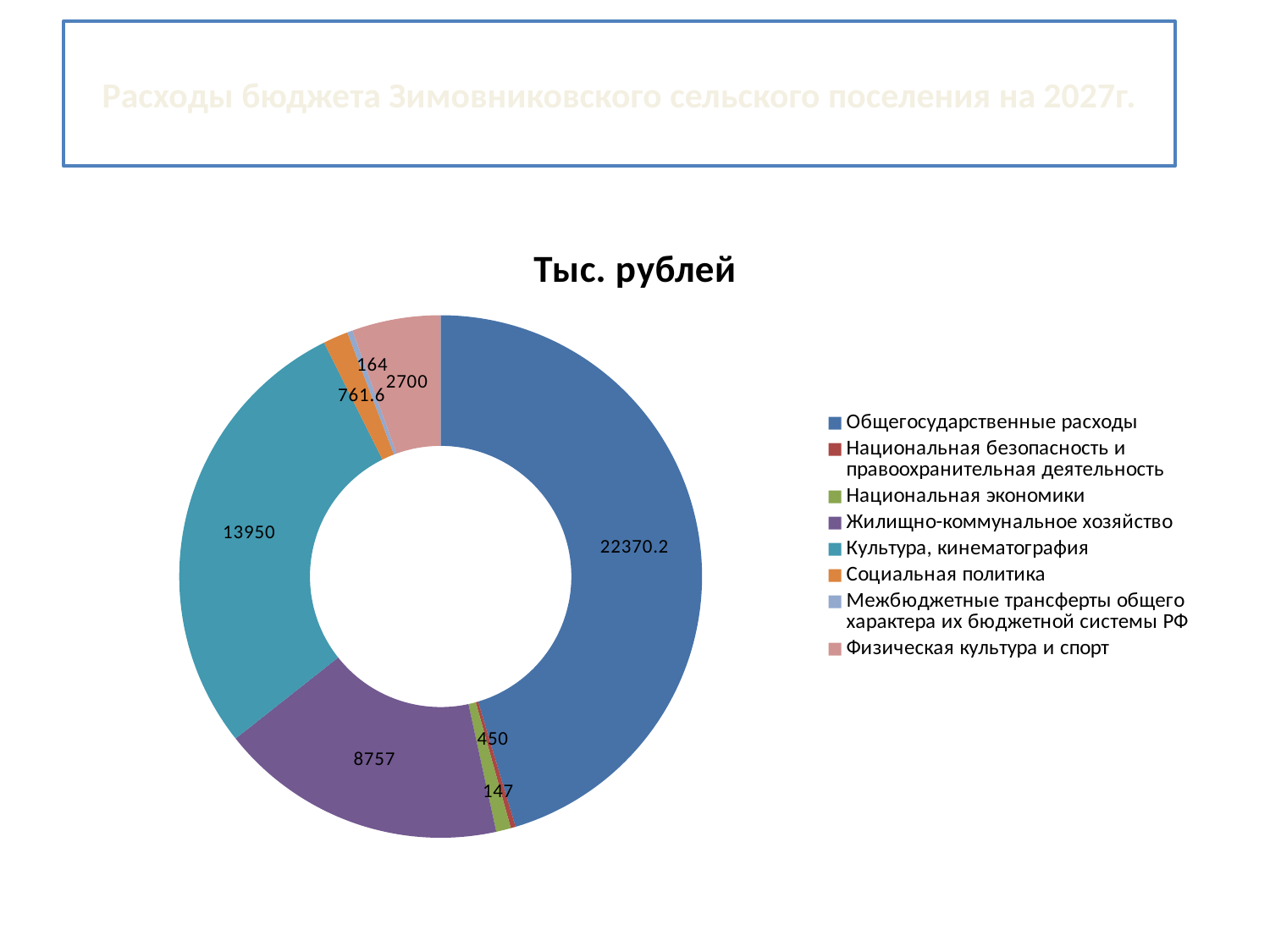
What is the title of the chart? Тыс. рублей Which category has the highest value? Общегосударственные расходы What is the value for Общегосударственные расходы? 22370.2 What kind of chart is shown on the slide? doughnut chart What is the value for Культура, кинематография? 13950 How many categories does the chart show? 8 Which category has the lowest value? Национальная безопасность и правоохранительная деятельность What is the value for Социальная политика? 761.6 What is the difference between Общегосударственные расходы and Культура, кинематография? 8420.2 What is the difference between Национальная экономики and Национальная безопасность и правоохранительная деятельность? 303 Which is larger, Жилищно-коммунальное хозяйство or Физическая культура и спорт? Жилищно-коммунальное хозяйство What is the value for Физическая культура и спорт? 2700